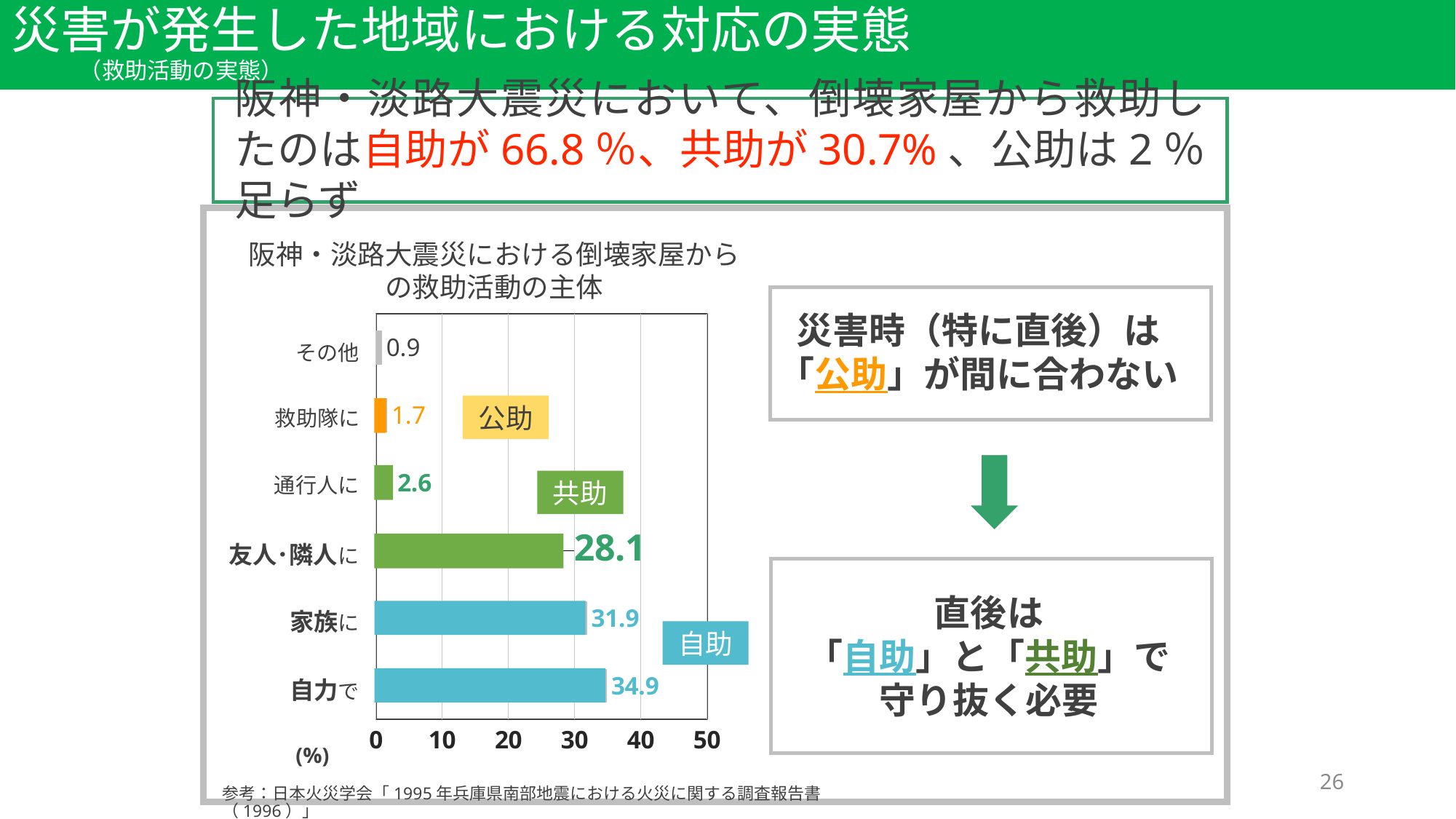
What is the value for その他? 0.9 How many categories are shown in the chart? 6 What is the value for 救助隊に? 1.7 What is the value for 家族に? 31.9 Which category has the lowest value? その他 What is the difference between the values for 自力で and 家族に? 3.0 What is the title of the chart? 阪神・淡路大震災における倒壊家屋からの救助活動の主体 What is the value for 自力で? 34.9 What type of chart is shown on the slide? bar chart What is the value for 友人・隣人に? 28.1 Which category has the highest value? 自力で Which is larger, the value for 通行人に or the value for 救助隊に? 通行人に